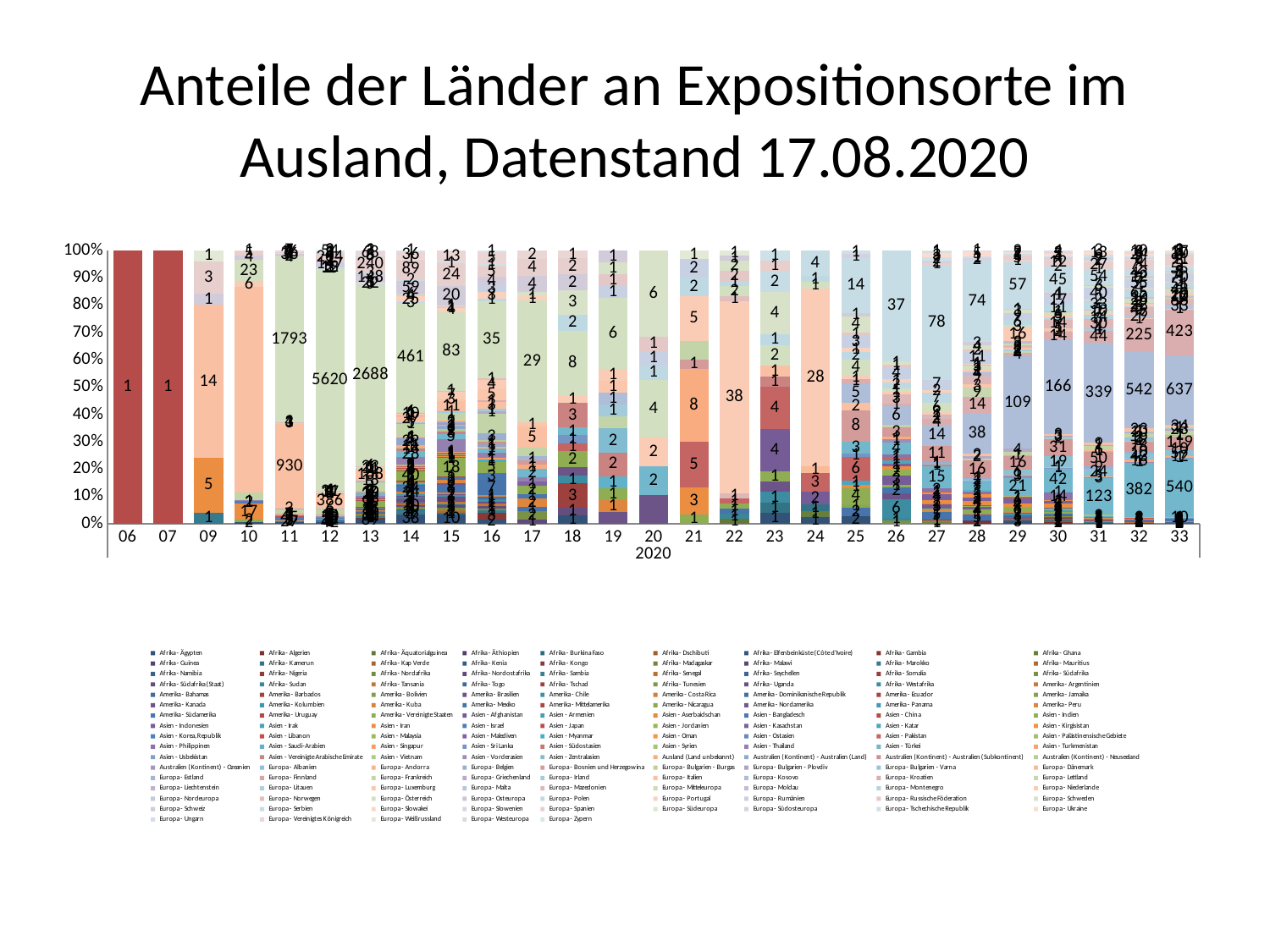
What is the largest value labelled in the bar for week 32? 542 How many bars (calendar weeks) are plotted along the x axis? 27 What is the largest value labelled in the bar for week 33? 637 Which is larger: the largest labelled value in week 12 or the largest labelled value in week 13? week 12 What is the title of the chart? Anteile der Länder an Expositionsorte im Ausland, Datenstand 17.08.2020 What is the largest value labelled in the bar for week 11? 1793 What kind of chart is shown on the slide? bar chart Which year is shown beneath the week numbers on the x axis? 2020 What is the largest value labelled in the bar for week 13? 2688 What is the largest value labelled in the bar for week 12? 5620 What value is labelled in the single segment of the bar for week 06? 1 What is the largest value labelled in the bar for week 14? 461